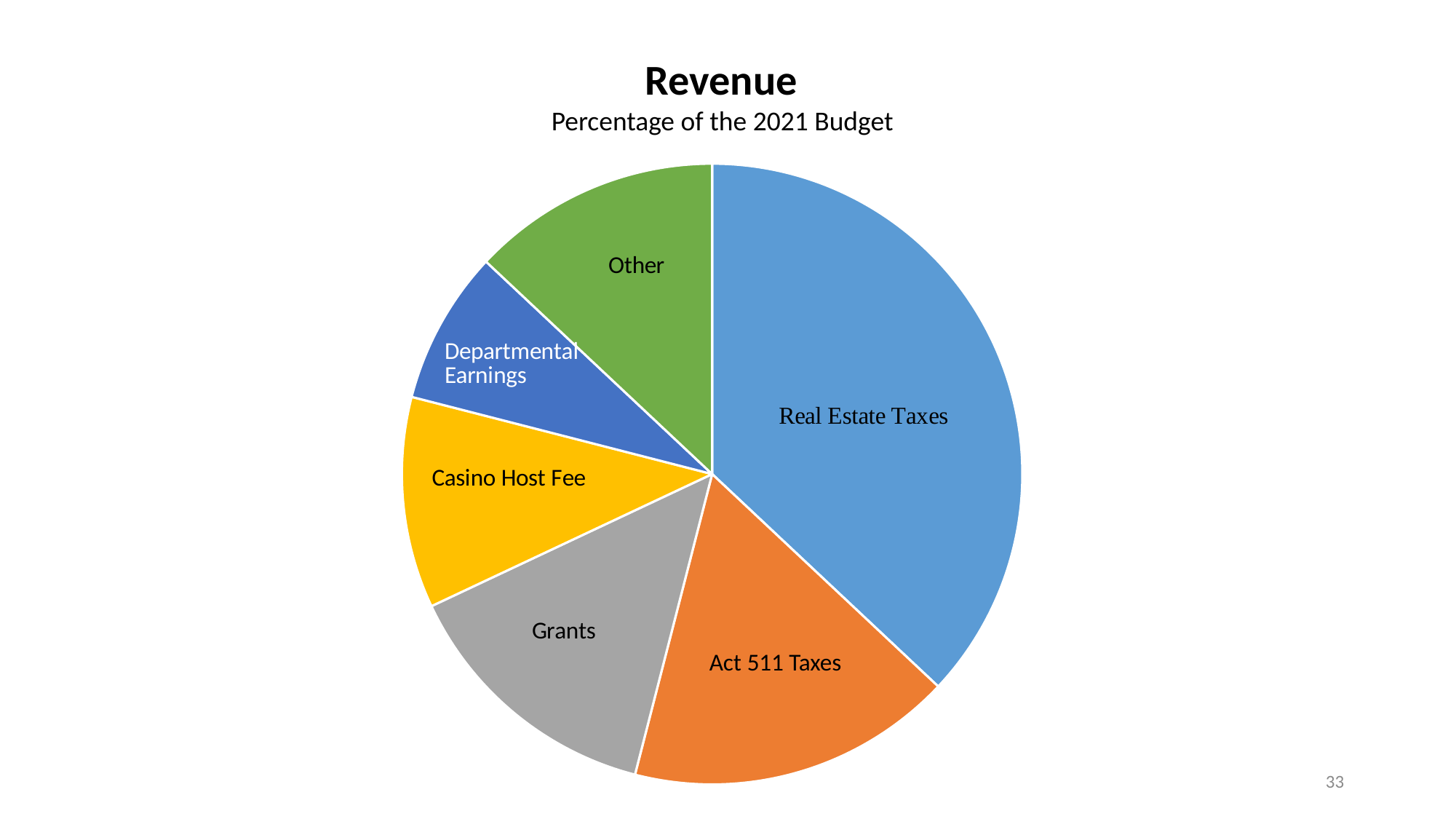
What is the title of the chart? Revenue How many slices does the pie chart have? 6 Which is larger, the slice for Act 511 Taxes or the slice for Departmental Earnings? Act 511 Taxes Which category has the smallest slice of the pie? Departmental Earnings Which category has the largest slice of the pie? Real Estate Taxes Which is larger, the slice for Grants or the slice for Departmental Earnings? Grants What does the subtitle under the chart title say? Percentage of the 2021 Budget Which is larger, the slice for Casino Host Fee or the slice for Real Estate Taxes? Real Estate Taxes What kind of chart is shown on the slide? Pie chart